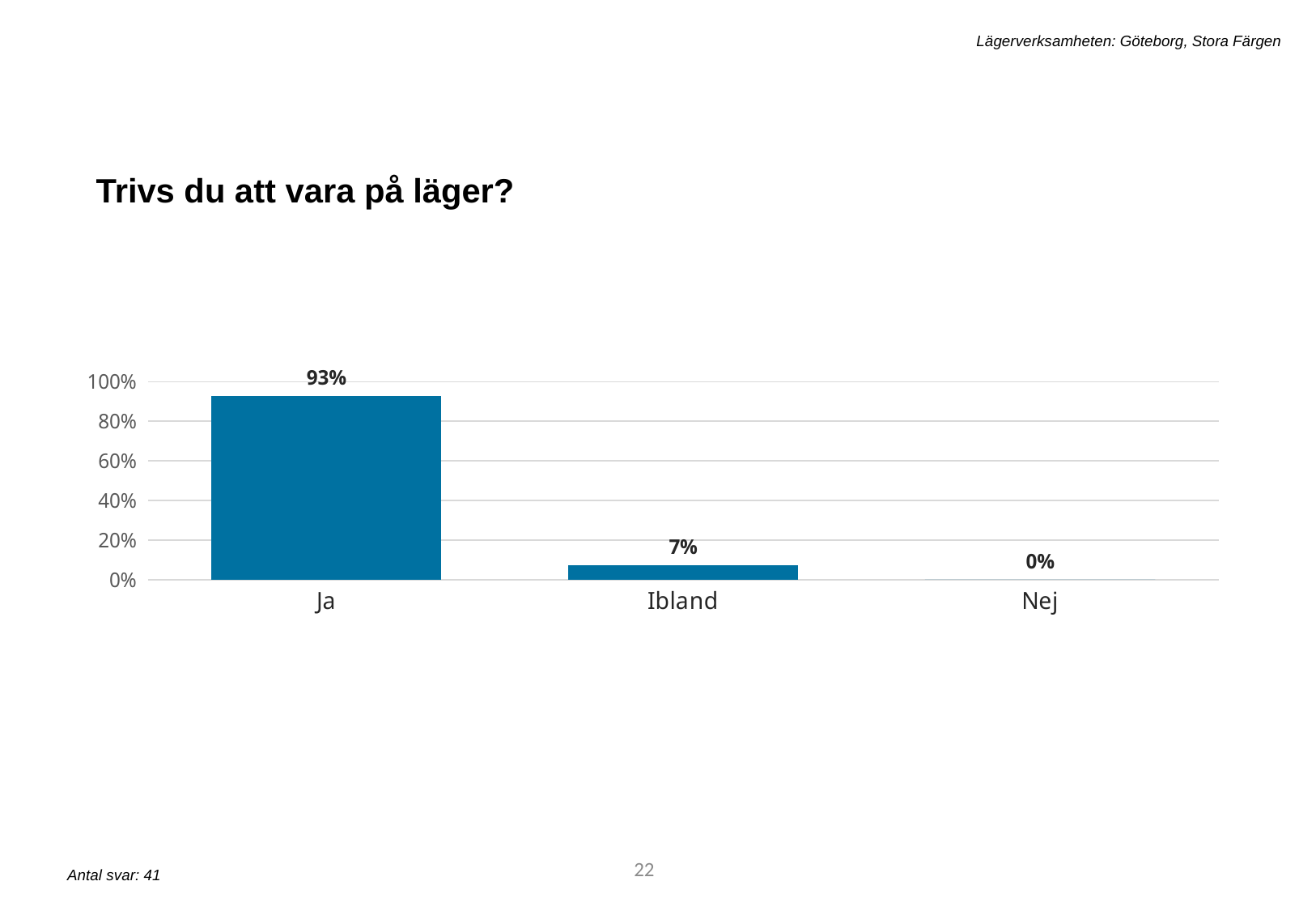
What kind of chart is shown on the slide? bar chart Which category has the lowest value? Nej How many categories are shown on the x axis? 3 What is the value for Ja? 93% Is the value for Ja greater or less than 80%? greater Do the values rise or fall from left to right along the x axis? fall What is the value for Ibland? 7% Which is larger, the value for Ibland or the value for Nej? Ibland What is the difference between the values for Ja and Ibland? 86% What is the title of the chart? Trivs du att vara på läger? Which category has the highest value? Ja What is the value for Nej? 0%